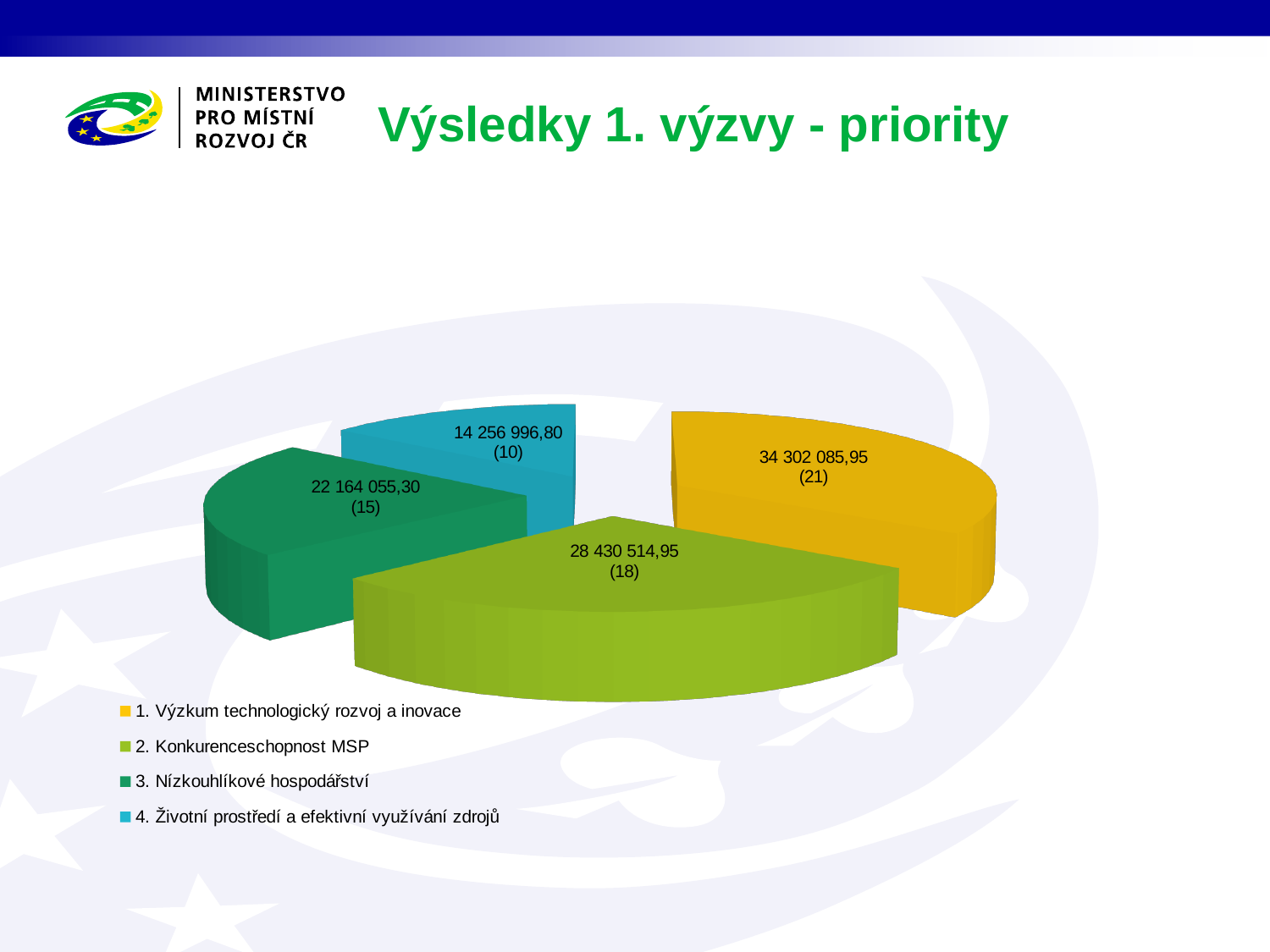
What value is shown for the slice '3. Nízkouhlíkové hospodářství'? 22 164 055,30 Which priority has the largest slice of the pie? 1. Výzkum technologický rozvoj a inovace What value is shown for the slice '4. Životní prostředí a efektivní využívání zdrojů'? 14 256 996,80 Which is larger, the value for '3. Nízkouhlíkové hospodářství' or for '4. Životní prostředí a efektivní využívání zdrojů'? 3. Nízkouhlíkové hospodářství What value is shown for the slice '1. Výzkum technologický rozvoj a inovace'? 34 302 085,95 Which priority has the smallest slice of the pie? 4. Životní prostředí a efektivní využívání zdrojů What is the title of the slide containing the pie chart? Výsledky 1. výzvy - priority What value is shown for the slice '2. Konkurenceschopnost MSP'? 28 430 514,95 What number in parentheses is shown for the slice '1. Výzkum technologický rozvoj a inovace'? 21 What kind of chart is shown on the slide? pie chart What is the difference between the values for '1. Výzkum technologický rozvoj a inovace' and '2. Konkurenceschopnost MSP'? 5 871 571,00 How many slices does the pie chart have? 4